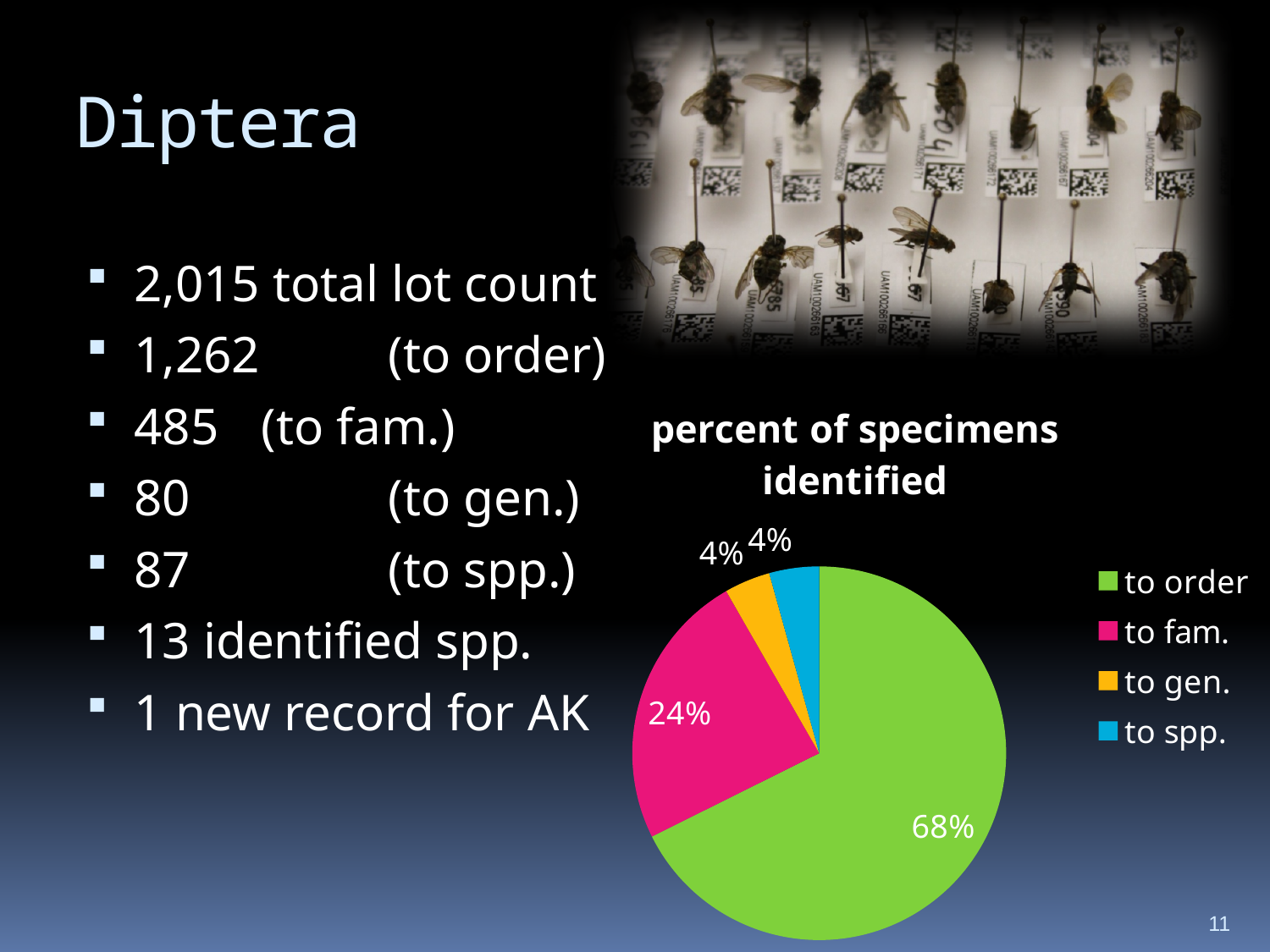
What colour is the 'to order' slice in the pie chart? green How many entries does the legend list? 4 What percentage of specimens were identified to fam.? 24% What is the title of the chart? percent of specimens identified What kind of chart is shown on the slide? pie chart What is the difference in percentage points between the 'to order' slice and the 'to fam.' slice? 44 What percentage of specimens were identified to gen.? 4% Which category has the largest slice of the pie? to order What percentage of specimens were identified to spp.? 4% Which slice is larger, 'to fam.' or 'to gen.'? to fam. What percentage of specimens were identified to order? 68% How many slices does the pie chart have? 4